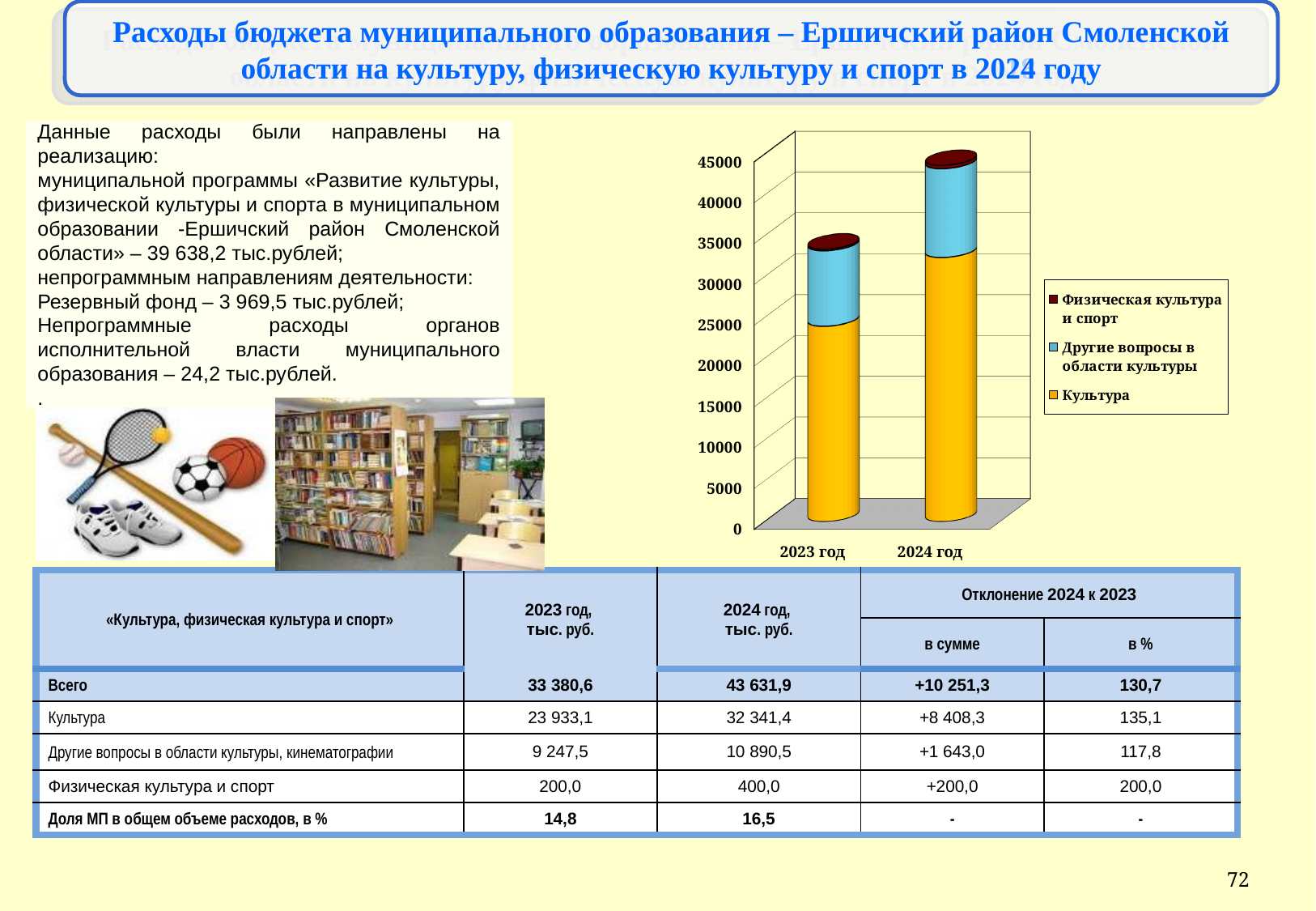
Is the Культура segment for 2024 год greater or less than 30000? greater Which series is shown in yellow in the chart legend? Культура How many series does the chart legend list? 3 Which year has the taller stacked bar in the chart? 2024 год Is the total stacked bar for 2024 год greater or less than 40000? greater Which year has the shorter stacked bar in the chart? 2023 год What kind of chart is shown on the slide? bar chart Is the total stacked bar for 2023 год greater or less than 30000? greater How many categories (years) are shown on the x axis of the chart? 2 What is the highest value labelled on the chart's vertical axis? 45000 Do the stacked bar totals rise or fall from 2023 год to 2024 год? rise